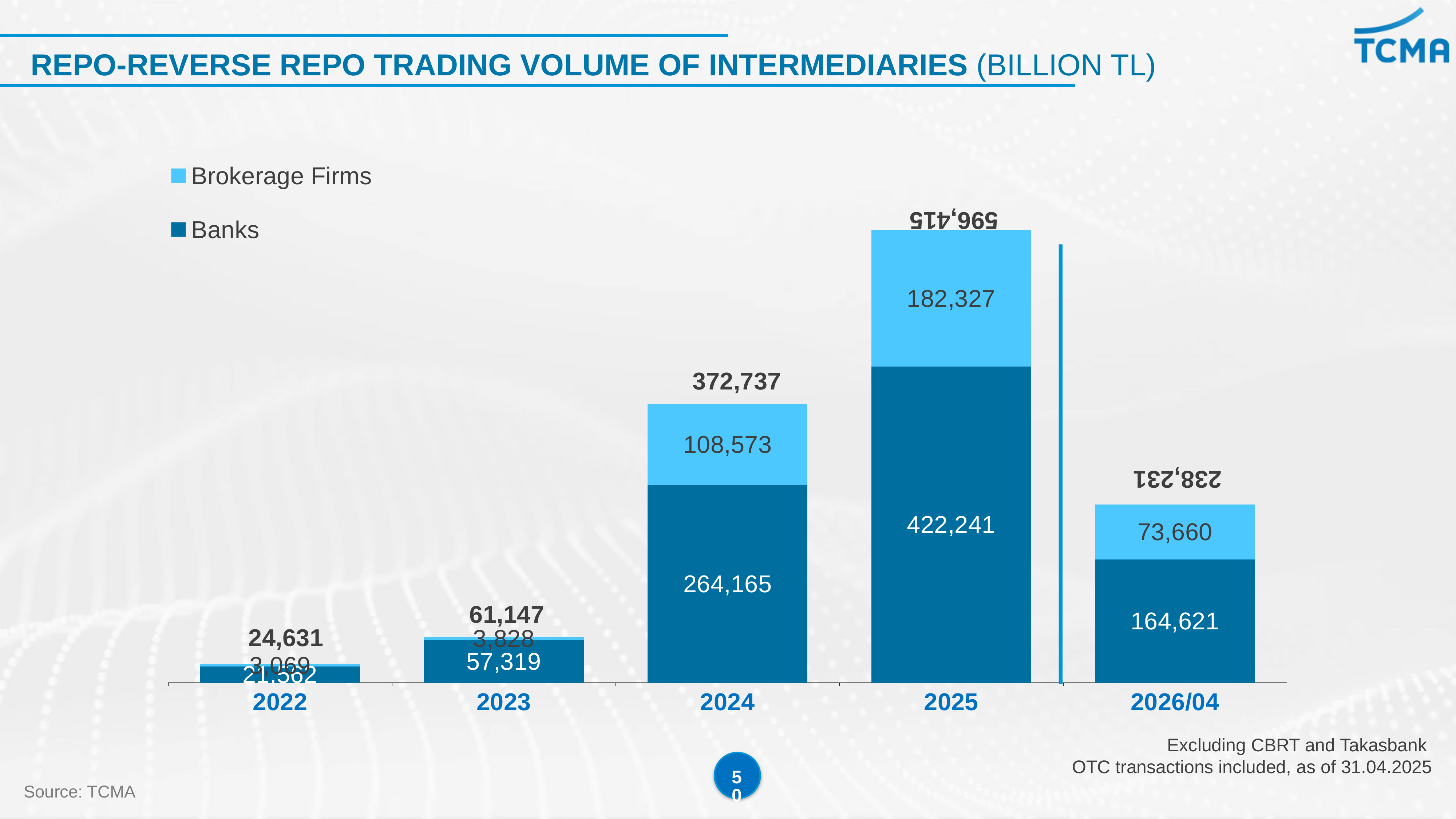
What is the difference between the Banks value in 2025 and in 2024? 158,076 What is the Banks value for 2024? 264,165 How many periods are shown on the x axis? 5 In which period is the Banks value highest? 2025 What kind of chart is shown on the slide? Stacked bar chart What is the total trading volume shown for 2024? 372,737 What is the Brokerage Firms value for 2026/04? 73,660 Which is larger, the Brokerage Firms value for 2024 or for 2026/04? 2024 What is the Brokerage Firms value for 2025? 182,327 How many series does the legend list? 2 What is the total trading volume shown for 2023? 61,147 What is the Banks value for 2023? 57,319